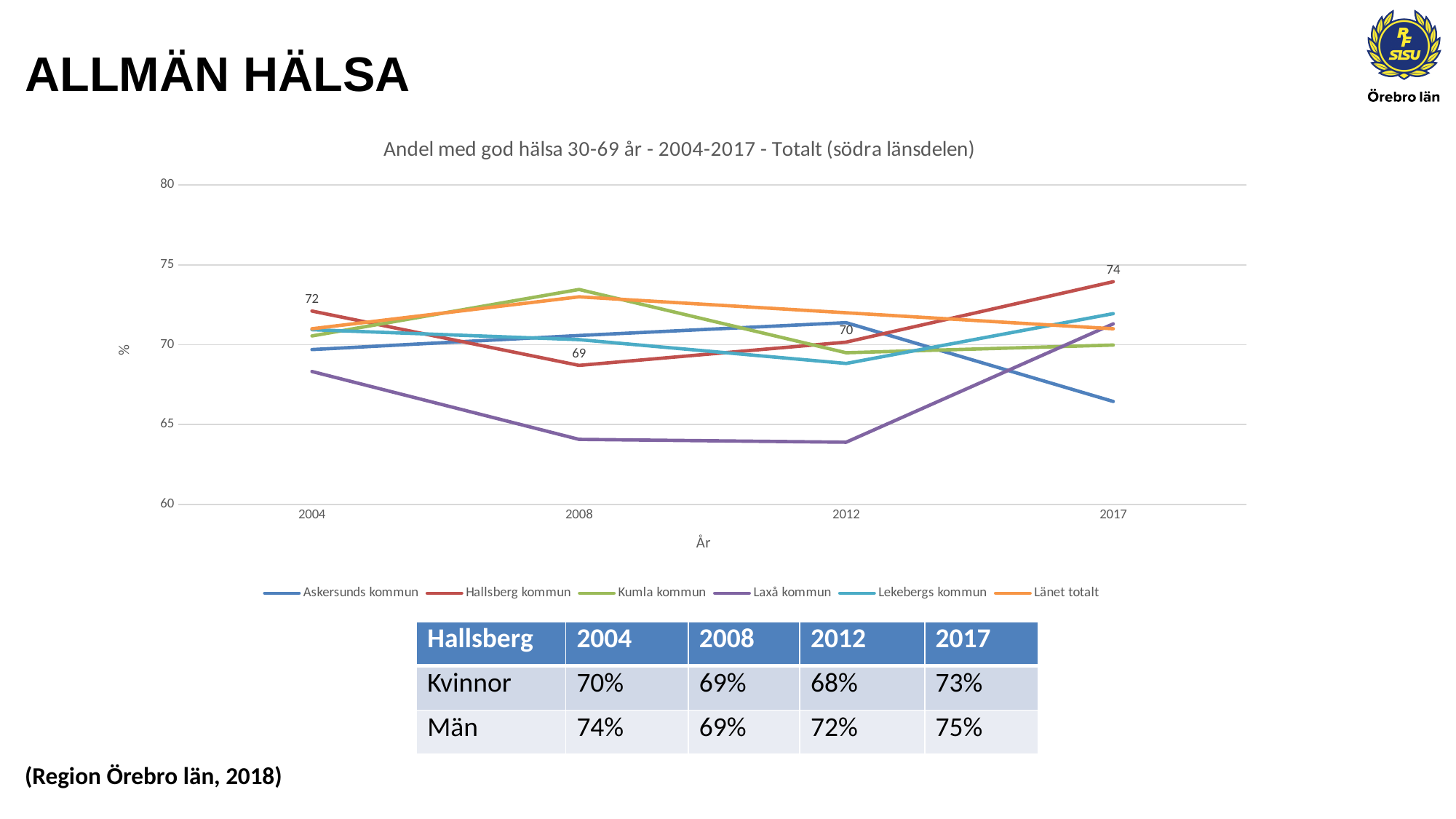
In which year is the value for Hallsberg kommun highest? 2017 Does the line for Laxå kommun rise or fall between 2012 and 2017? rise How many series does the legend of the chart list? 6 What is the value for Hallsberg kommun in 2008? 69 What is the difference between the Hallsberg kommun values for 2017 and 2008? 5 Is the value for Askersunds kommun in 2017 greater or less than 70? less What is the value for Hallsberg kommun in 2017? 74 How many years are plotted along the x axis of the chart? 4 Is the value for Laxå kommun in 2012 greater or less than 65? less In which year is the value for Hallsberg kommun lowest? 2008 What kind of chart is shown on the slide? line chart What is the value for Hallsberg kommun in 2004? 72